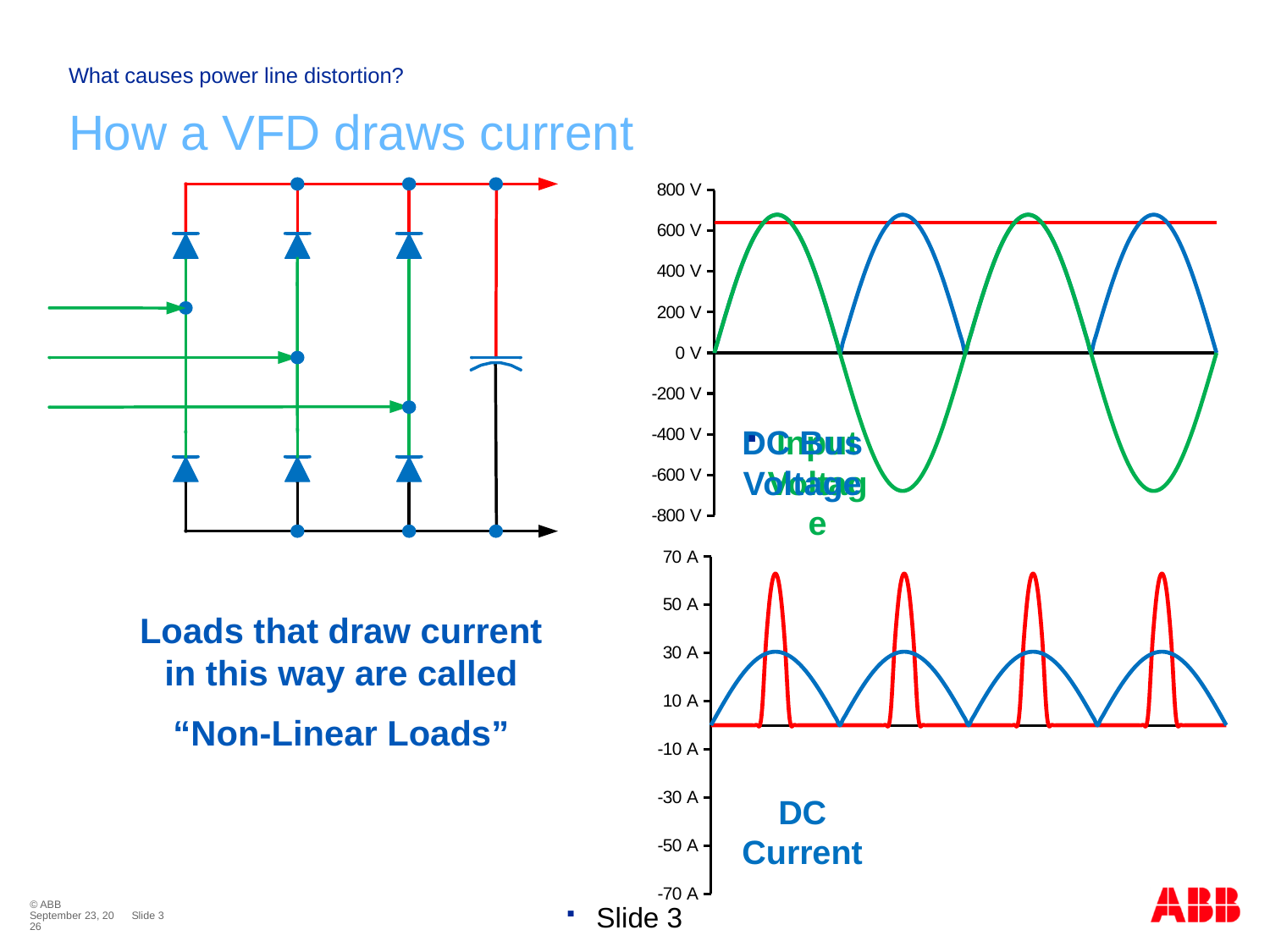
In the top voltage chart, is the value of the flat red horizontal line greater or less than 800 V? less What kind of chart is the bottom chart on the right (the current chart)? line chart In the top voltage chart, is the peak of the green sine wave greater or less than 600 V? greater In the bottom current chart, is the peak of the blue humps greater or less than 50 A? less How many red spikes are plotted in the bottom current chart? 4 In the bottom current chart, which reaches a higher peak value, the red spikes or the blue humps? the red spikes What is the highest value shown on the vertical axis of the bottom current chart? 70 A What kind of chart is the top chart on the right (the voltage chart)? line chart